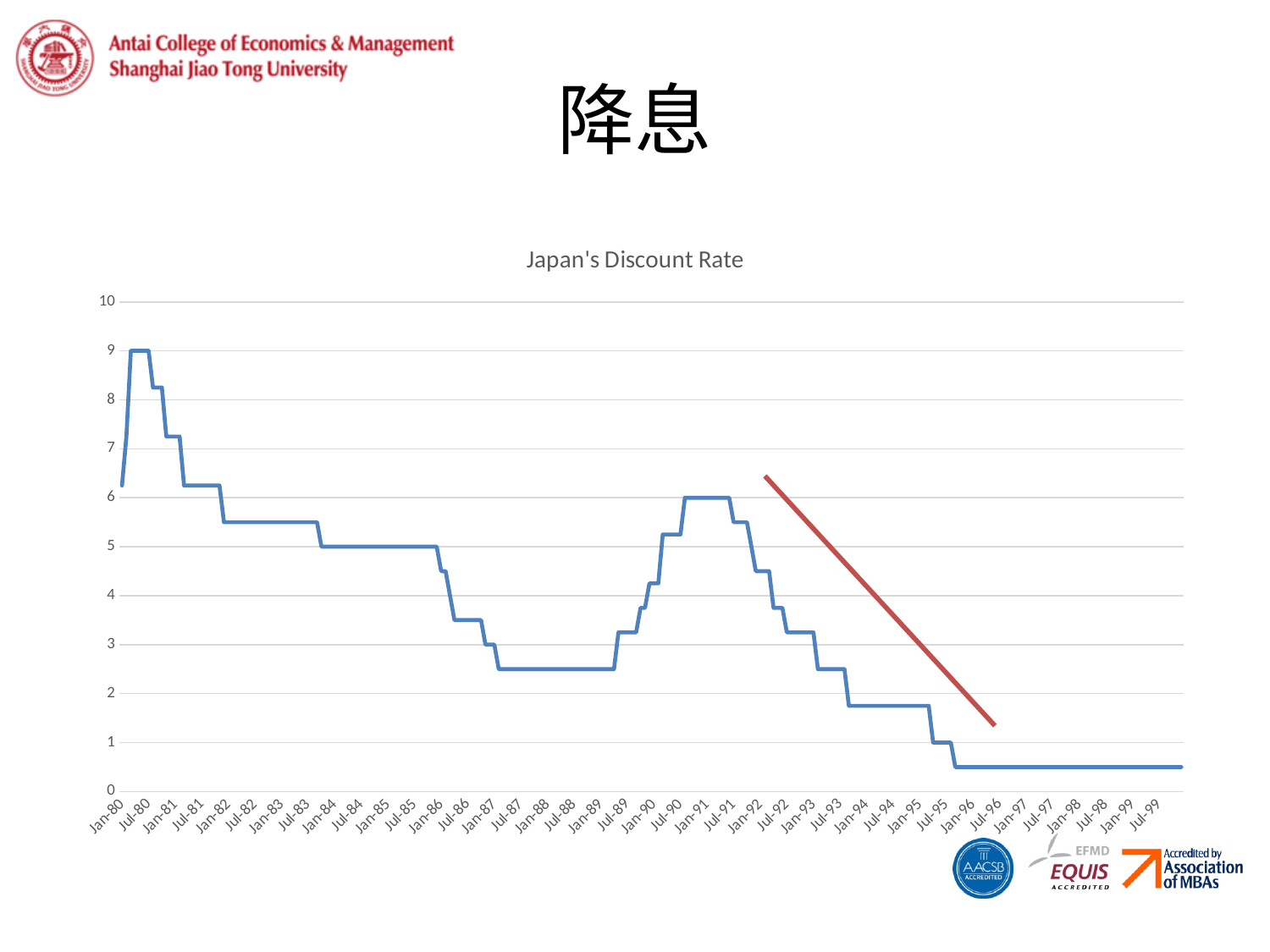
Is the discount rate at Jan-88 greater or less than 3? less What is the discount rate at Jan-91? 6 What is the highest value the discount rate reaches on the chart? 9 What is the discount rate at Jan-85? 5 Does the discount rate rise or fall between Jan-89 and Jan-91? rise What is the first date label on the x axis? Jan-80 Is the discount rate at Jan-98 greater or less than 1? less Is the discount rate at Jan-81 greater or less than 6? greater Which is higher, the discount rate at Jan-85 or at Jan-95? Jan-85 What is the title of the chart? Japan's Discount Rate Does the discount rate rise or fall between Jan-91 and Jan-96? fall What kind of chart is shown on the slide? line chart